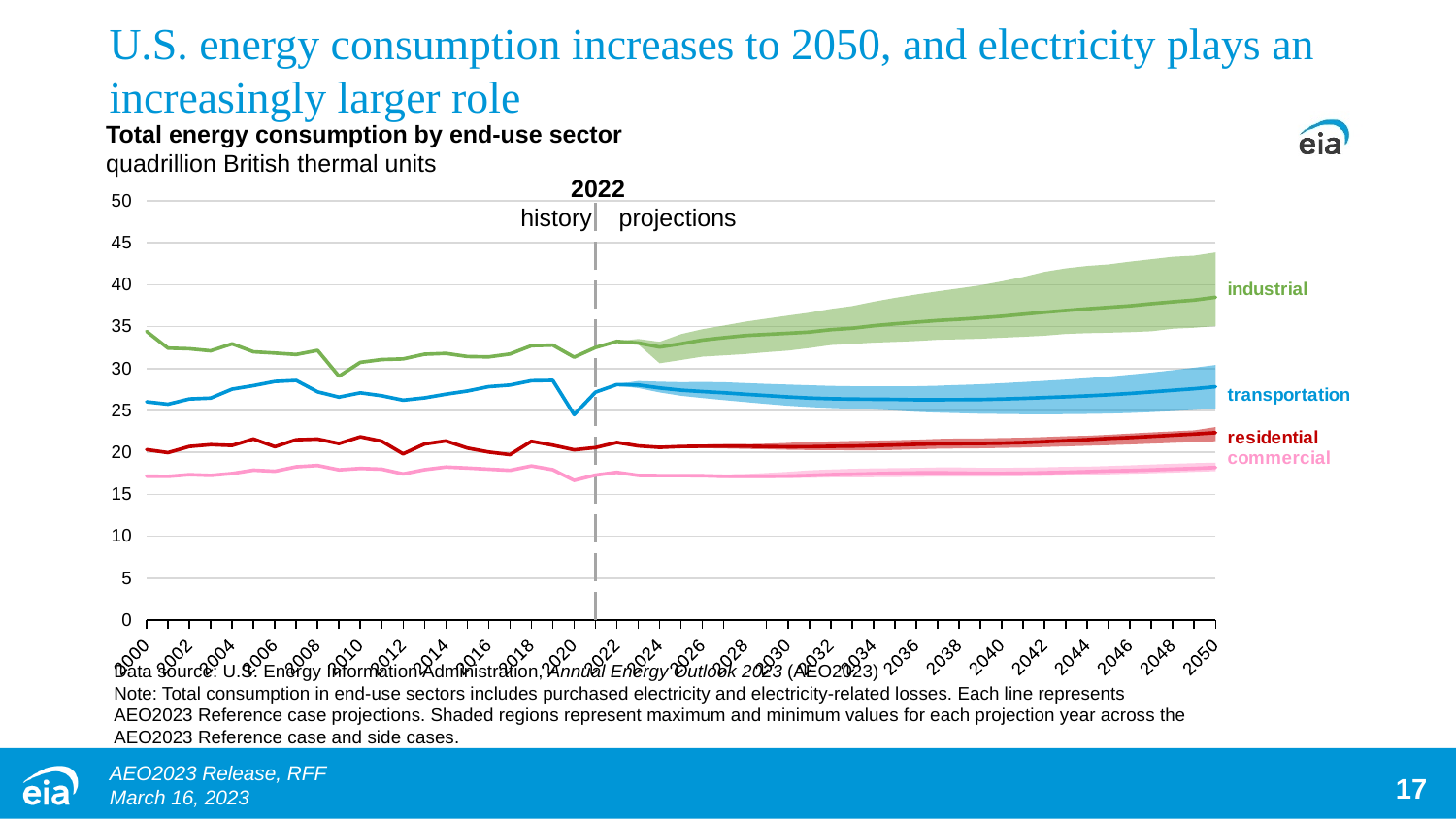
Which sector has the lowest energy consumption in 2050? commercial How many sectors (series) are plotted on the chart? 4 What unit is the energy consumption measured in on the chart? quadrillion British thermal units What kind of chart is shown on the slide? line chart Which sector has the highest energy consumption in 2050? industrial Is the value for transportation in 2050 greater or less than 30? less Which year marks the boundary between history and projections on the chart? 2022 Is the value for industrial in 2000 greater or less than 30? greater Is the value for commercial in 2000 greater or less than 20? less Does the industrial line rise or fall between 2022 and 2050? rise Which is larger in 2050, industrial or transportation? industrial